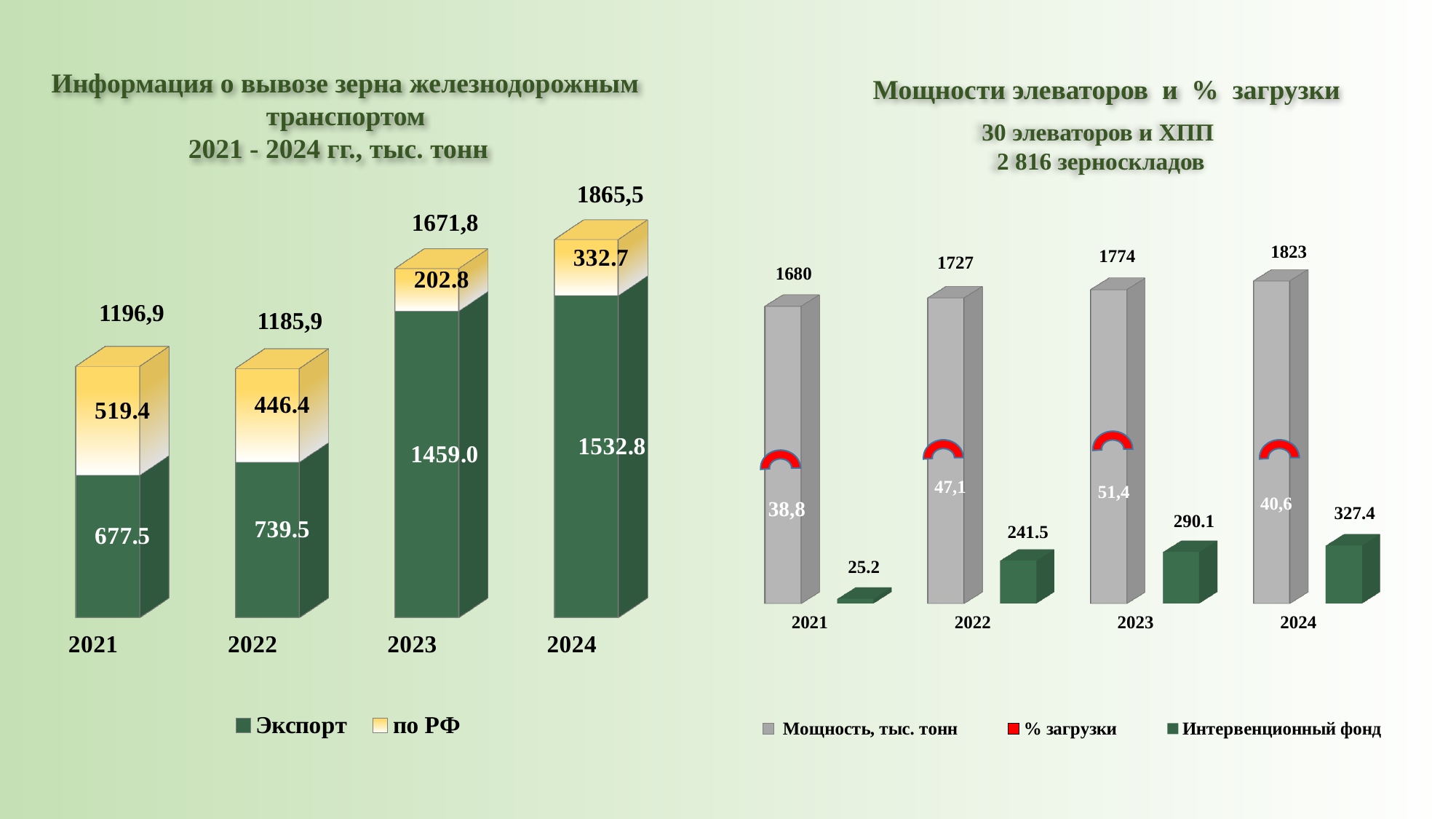
In the right chart (Мощности элеваторов и % загрузки), how many years are shown on the x axis? 4 In the left chart (Информация о вывозе зерна железнодорожным транспортом), how many series does the legend list? 2 In the right chart (Мощности элеваторов и % загрузки), does the Мощность, тыс. тонн value rise or fall from 2021 to 2024? rise In the left chart (Информация о вывозе зерна железнодорожным транспортом), what is the Экспорт value for 2023? 1459.0 In the left chart (Информация о вывозе зерна железнодорожным транспортом), what is the total of the stacked bar for 2024? 1865,5 In the left chart (Информация о вывозе зерна железнодорожным транспортом), what is the по РФ value for 2021? 519.4 In the right chart (Мощности элеваторов и % загрузки), which year has the highest Интервенционный фонд value? 2024 In the right chart (Мощности элеваторов и % загрузки), which is larger: the % загрузки for 2022 or for 2024? 2022 In the right chart (Мощности элеваторов и % загрузки), what is the % загрузки value for 2023? 51,4 In the left chart (Информация о вывозе зерна железнодорожным транспортом), what is the difference between the Экспорт values for 2024 and 2023? 73.8 In the left chart (Информация о вывозе зерна железнодорожным транспортом), which year has the lowest по РФ value? 2023 In the right chart (Мощности элеваторов и % загрузки), what is the Мощность, тыс. тонн value for 2022? 1727